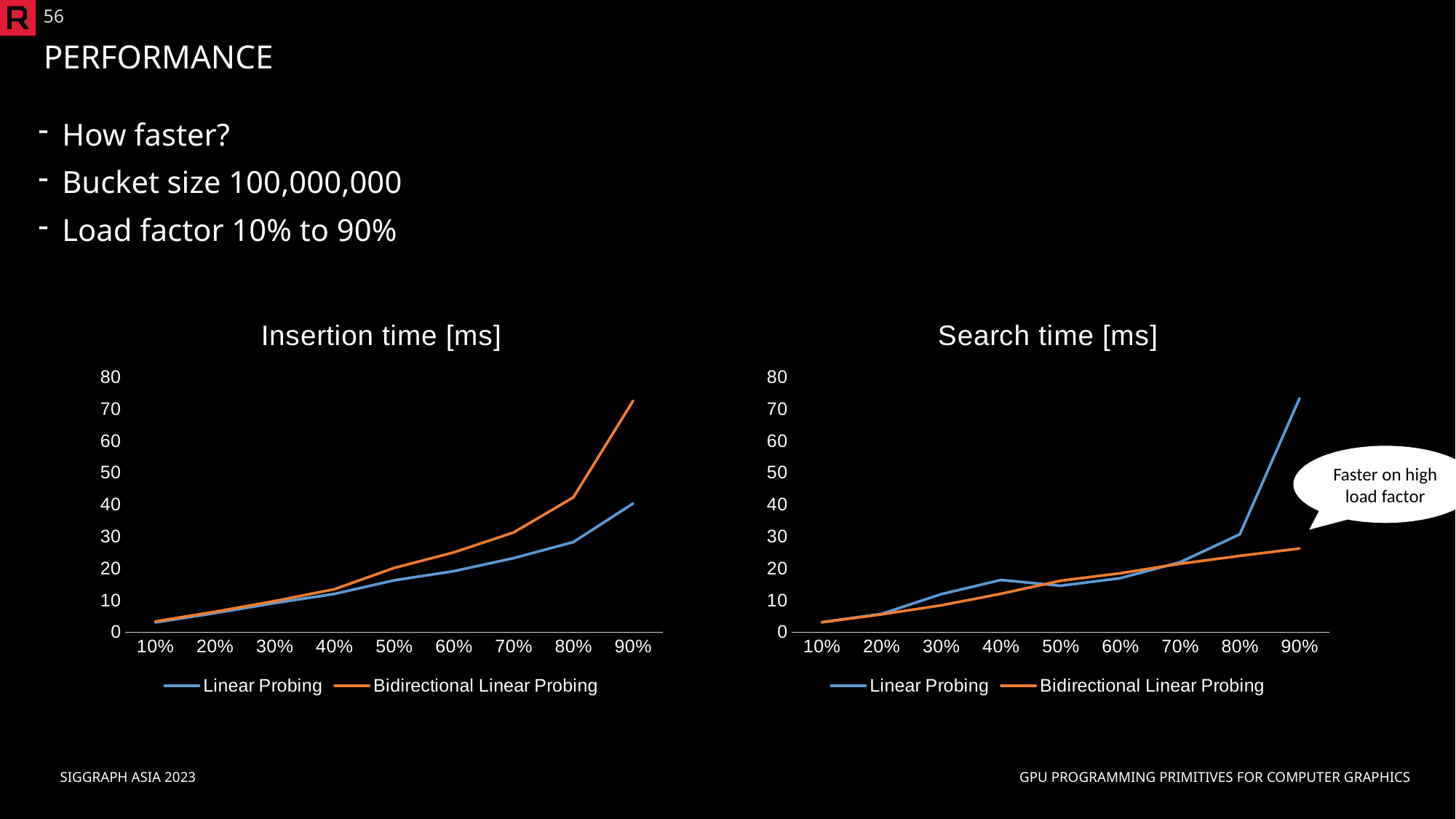
How many series does the legend of the Search time [ms] chart list? 2 In the Search time [ms] chart, is the Bidirectional Linear Probing value at 90% greater or less than 40? less What is the title of the chart on the right side of the slide? Search time [ms] In the Search time [ms] chart, which series has the higher value at 90% load factor? Linear Probing How many load factor values are plotted along the x axis of the Insertion time [ms] chart? 9 What kind of chart is the Insertion time [ms] chart? line chart In the Insertion time [ms] chart, do the Bidirectional Linear Probing values rise or fall as the load factor increases? rise In the Insertion time [ms] chart, which series has the higher value at 90% load factor? Bidirectional Linear Probing In the Search time [ms] chart, at which load factor does Linear Probing reach its highest value? 90% In the Insertion time [ms] chart, is the Linear Probing value at 90% greater or less than 50? less In the Insertion time [ms] chart, is the Bidirectional Linear Probing value at 90% greater or less than 60? greater